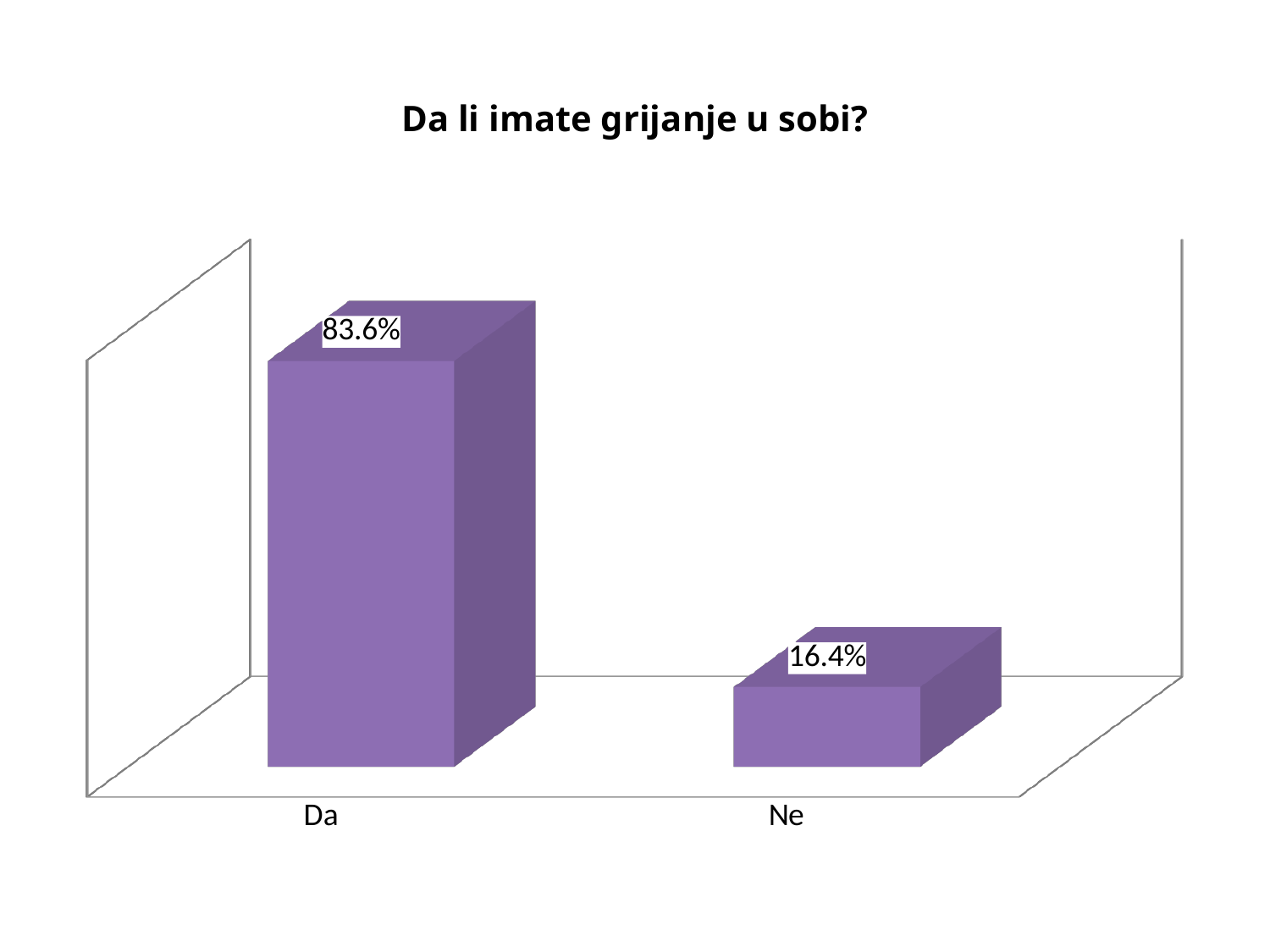
Which category has the lowest value? Ne Which is larger, the value for "Da" or the value for "Ne"? Da Which category has the highest value? Da What is the total of the two values shown? 100% What colour are the bars in the chart? Purple How many categories are shown on the x axis? 2 Do the values rise or fall from left to right along the x axis? Fall What is the value for "Ne"? 16.4% What is the title of the chart? Da li imate grijanje u sobi? What kind of chart is shown on the slide? Bar chart What is the difference between the values for "Da" and "Ne"? 67.2% What is the value for "Da"? 83.6%